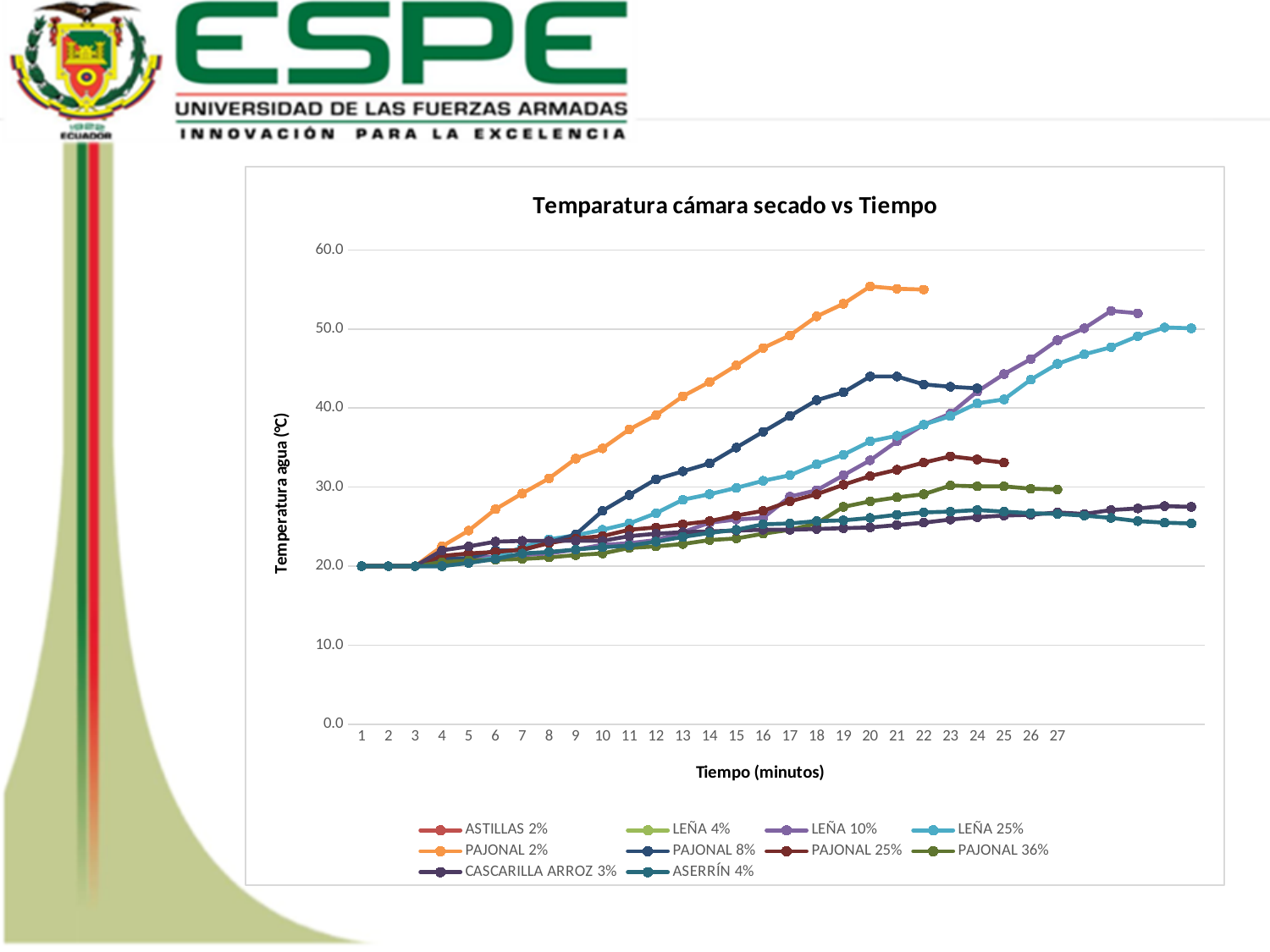
Does the PAJONAL 2% series rise or fall between minute 4 and minute 20? Rises Is the value for ASERRÍN 4% at minute 27 greater or less than 30.0? less Which series reaches the highest temperature on the chart? PAJONAL 2% Is the value for PAJONAL 36% at minute 23 greater or less than 40.0? less Is the value for PAJONAL 8% at minute 20 greater or less than 40.0? greater How many series does the legend list? 10 What is the value for PAJONAL 2% at minute 1? 20.0 What is the label of the x axis? Tiempo (minutos) What kind of chart is shown on the slide? Line chart What is the title of the chart? Temparatura cámara secado vs Tiempo